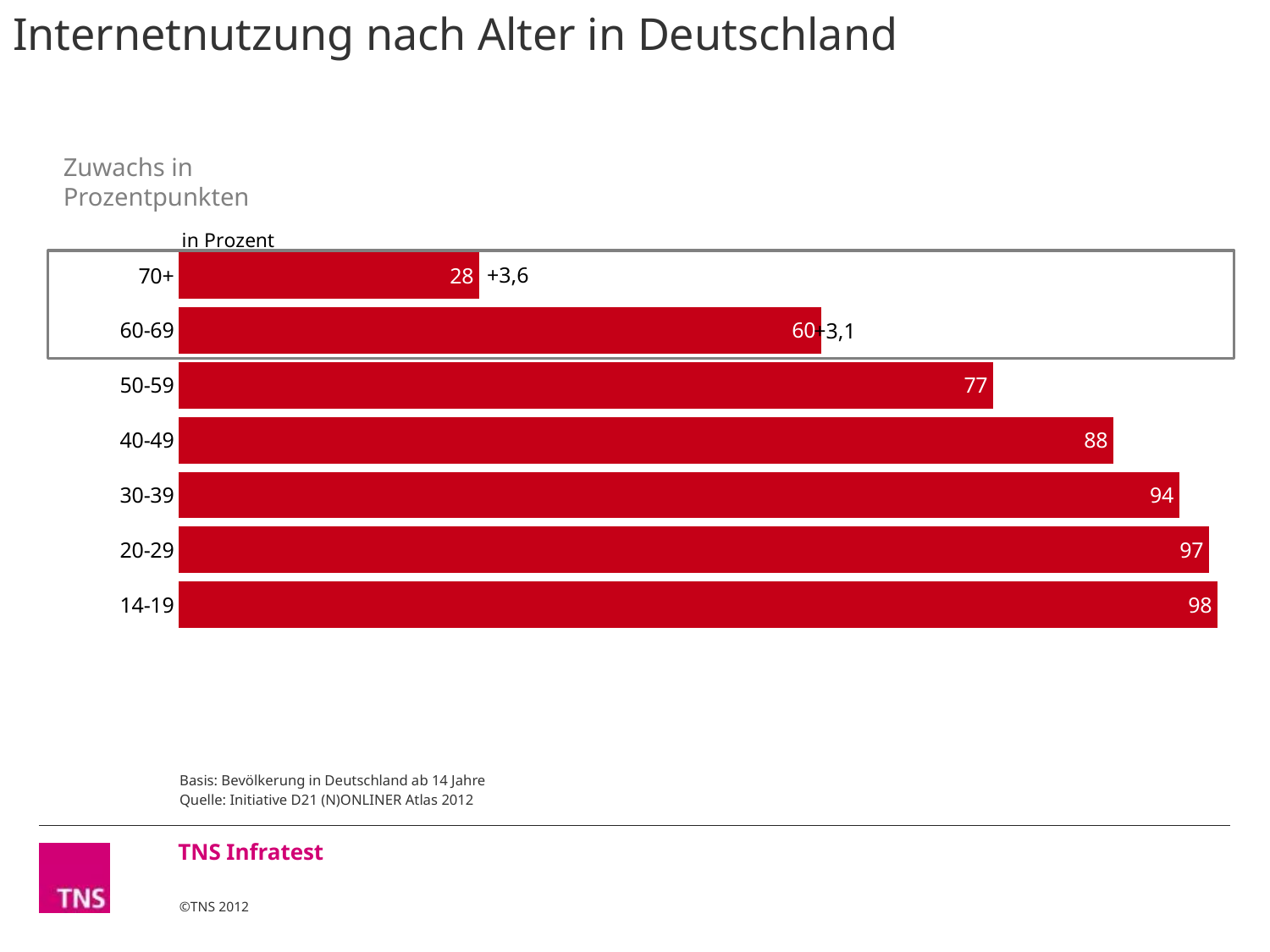
What is the Zuwachs in Prozentpunkten shown for the 60-69 age group? +3,1 Which age group has the lowest internet usage value? 70+ Which age group has a larger internet usage value, 30-39 or 50-59? 30-39 What kind of chart is shown on the slide? bar chart What is the internet usage value for the 50-59 age group? 77 What is the Zuwachs in Prozentpunkten shown for the 70+ age group? +3,6 What is the internet usage value for the 14-19 age group? 98 What is the title of the slide? Internetnutzung nach Alter in Deutschland What is the difference between the internet usage values for the 40-49 and 60-69 age groups? 28 Which age group has the highest internet usage value? 14-19 What is the internet usage value (in Prozent) for the 70+ age group? 28 How many age groups are shown in the chart? 7